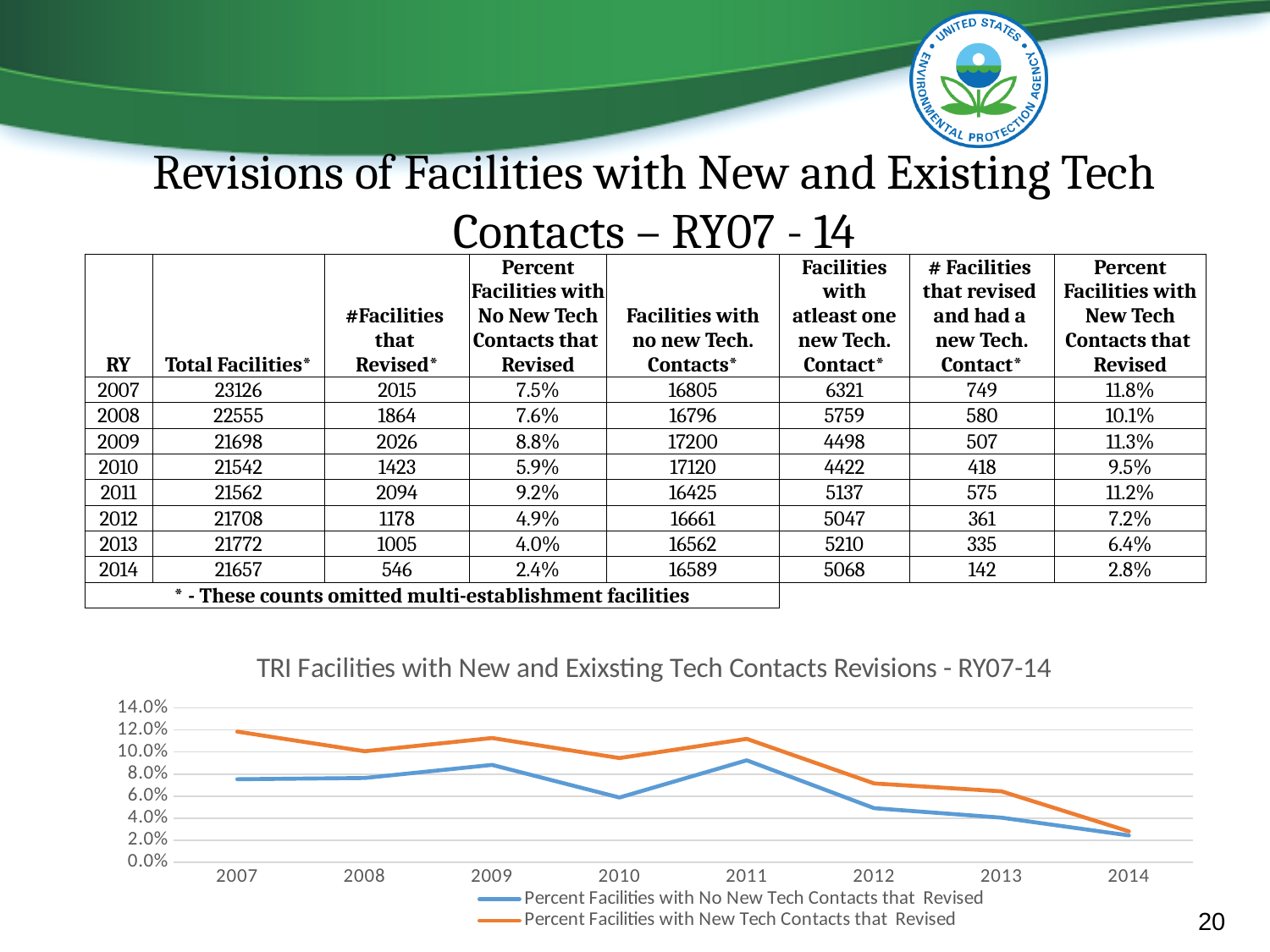
From 2011 to 2014, do both series in the chart rise or fall? Fall In which year is Percent Facilities with No New Tech Contacts that Revised lowest? 2014 What is the value of Percent Facilities with New Tech Contacts that Revised for 2014? 2.8% Is the value for Percent Facilities with New Tech Contacts that Revised in 2007 greater or less than 10.0%? greater What is the value of Percent Facilities with No New Tech Contacts that Revised for 2011? 9.2% What kind of chart is shown at the bottom of the slide? Line chart In which year is Percent Facilities with No New Tech Contacts that Revised highest? 2011 Is the value for Percent Facilities with No New Tech Contacts that Revised in 2013 greater or less than 6.0%? less What is the difference between Percent Facilities with New Tech Contacts that Revised (11.8%) and Percent Facilities with No New Tech Contacts that Revised (7.5%) in 2007? 4.3 percentage points How many reporting years are plotted along the x axis of the chart? 8 In 2012, which series has the larger value: Percent Facilities with New Tech Contacts that Revised or Percent Facilities with No New Tech Contacts that Revised? Percent Facilities with New Tech Contacts that Revised How many series does the legend of the chart list? 2